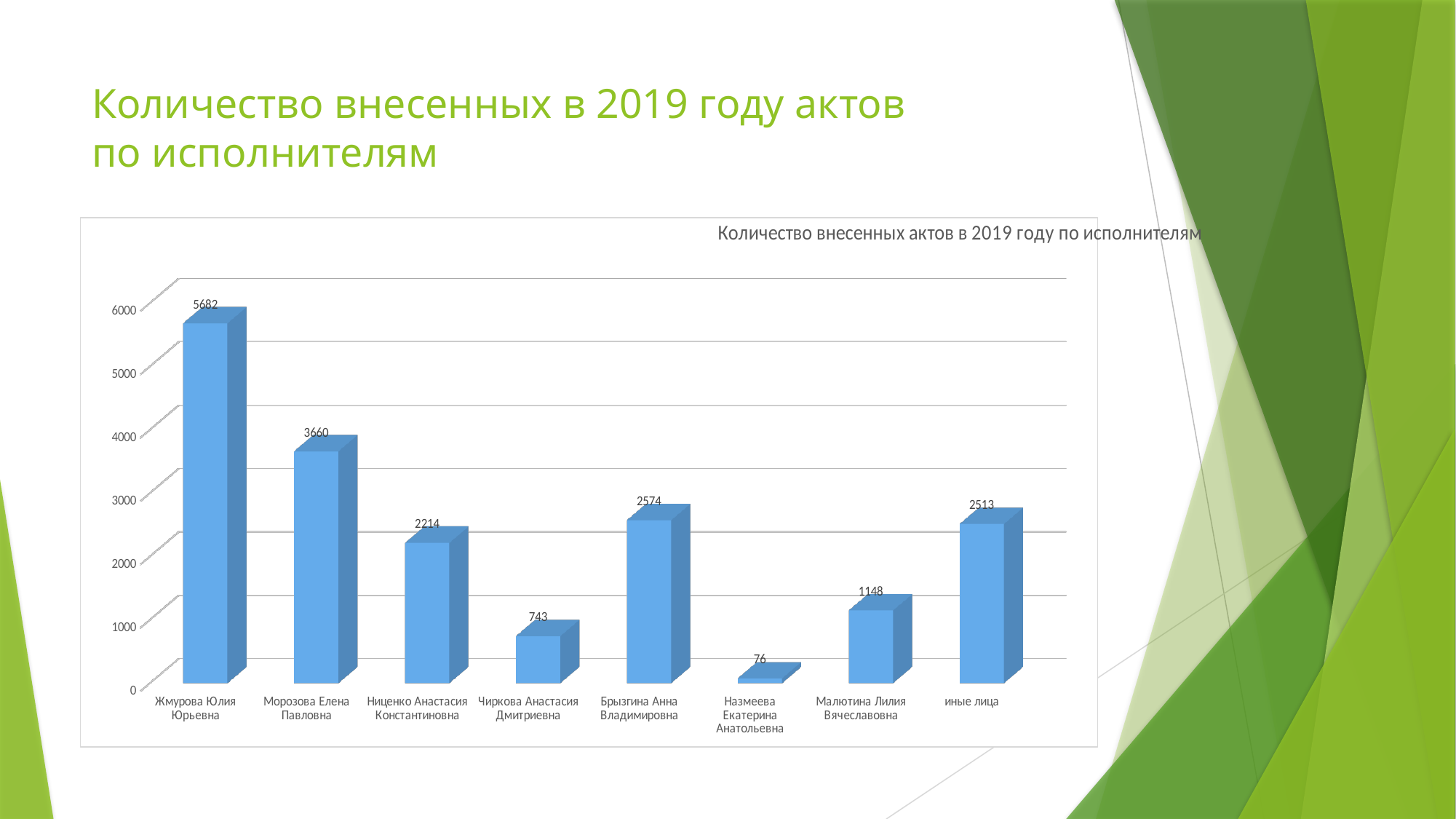
What is the value for Морозова Елена Павловна? 3660 Is the value for Малютина Лилия Вячеславовна greater or less than 1000? greater What is the difference between the values for Жмурова Юлия Юрьевна and Морозова Елена Павловна? 2022 Which category has the lowest value? Назмеева Екатерина Анатольевна What is the value for иные лица? 2513 What is the title of the chart? Количество внесенных актов в 2019 году по исполнителям What kind of chart is shown on the slide? bar chart What is the value for Назмеева Екатерина Анатольевна? 76 Which category has the highest value? Жмурова Юлия Юрьевна How many categories are shown on the x axis? 8 Which is larger, the value for Брызгина Анна Владимировна or the value for Ниценко Анастасия Константиновна? Брызгина Анна Владимировна What is the value for Жмурова Юлия Юрьевна? 5682